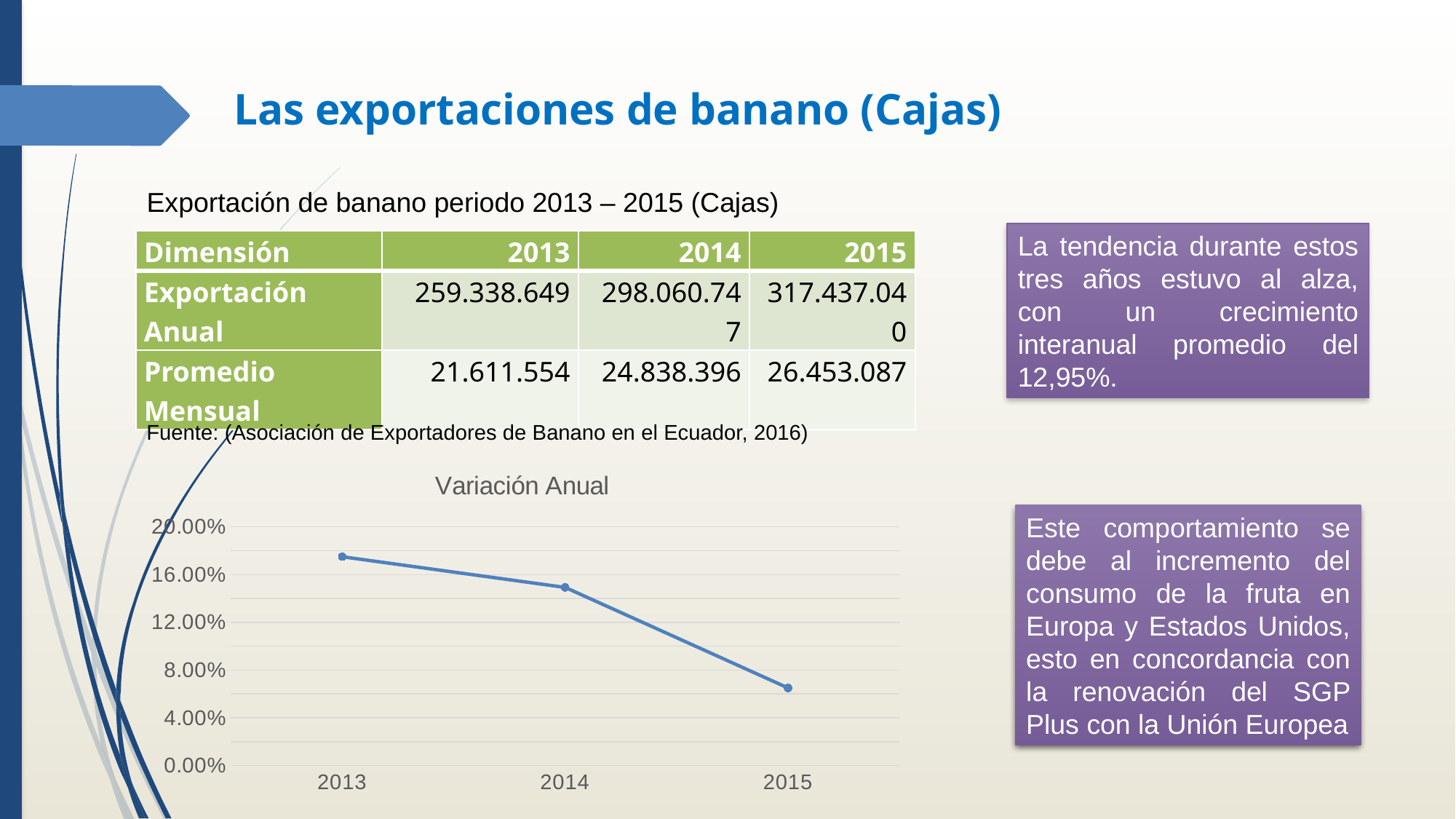
On the "Variación Anual" chart, is the value for 2013 greater or less than 16.00%? greater Which year has the lowest value on the "Variación Anual" chart? 2015 On the "Variación Anual" chart, which is larger, the value for 2014 or the value for 2015? 2014 Which year has the highest value on the "Variación Anual" chart? 2013 What is the title of the chart on the slide? Variación Anual On the "Variación Anual" chart, is the value for 2015 greater or less than 8.00%? less What kind of chart is the "Variación Anual" chart? line chart On the "Variación Anual" chart, is the value for 2014 greater or less than 12.00%? greater How many years are plotted on the "Variación Anual" chart? 3 What is the highest value shown on the vertical axis of the "Variación Anual" chart? 20.00% Do the values on the "Variación Anual" chart rise or fall from 2013 to 2015? fall